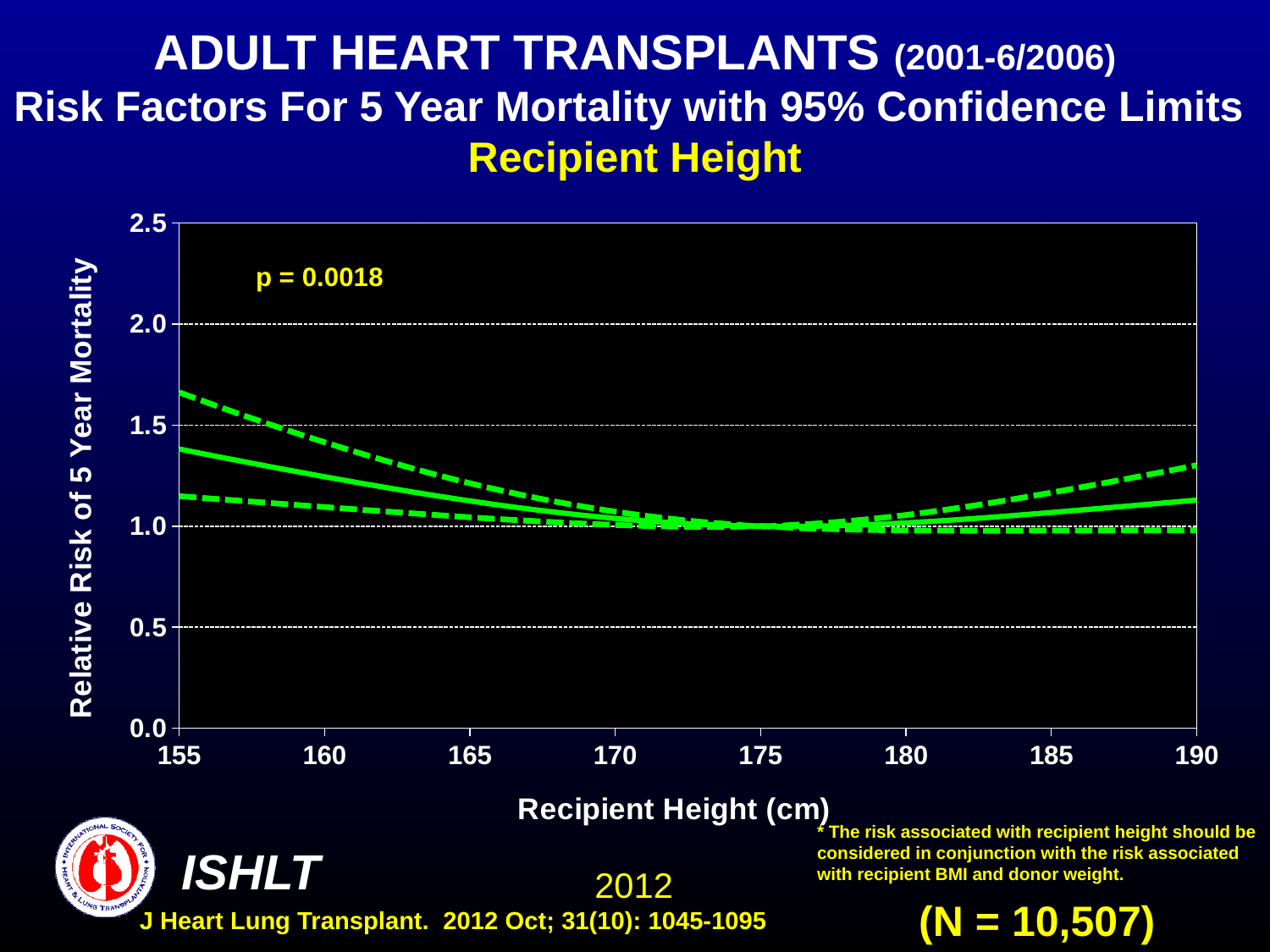
From a recipient height of 155 cm to 175 cm, does the relative risk of 5 year mortality (solid line) rise or fall? fall What kind of chart is shown on the slide? line chart Is the relative risk of 5 year mortality (solid line) higher at a recipient height of 155 cm or at 190 cm? 155 cm What p-value is printed on the chart? p = 0.0018 Is the upper confidence limit (upper dashed line) at a recipient height of 190 cm greater or less than 1.5? less Is the relative risk of 5 year mortality (solid line) at a recipient height of 155 cm greater or less than 1.0? greater Is the relative risk of 5 year mortality (solid line) at a recipient height of 155 cm greater or less than 1.5? less How many lines are plotted on the chart? 3 How many tick labels are shown on the x axis (Recipient Height)? 8 What is the label of the y axis? Relative Risk of 5 Year Mortality